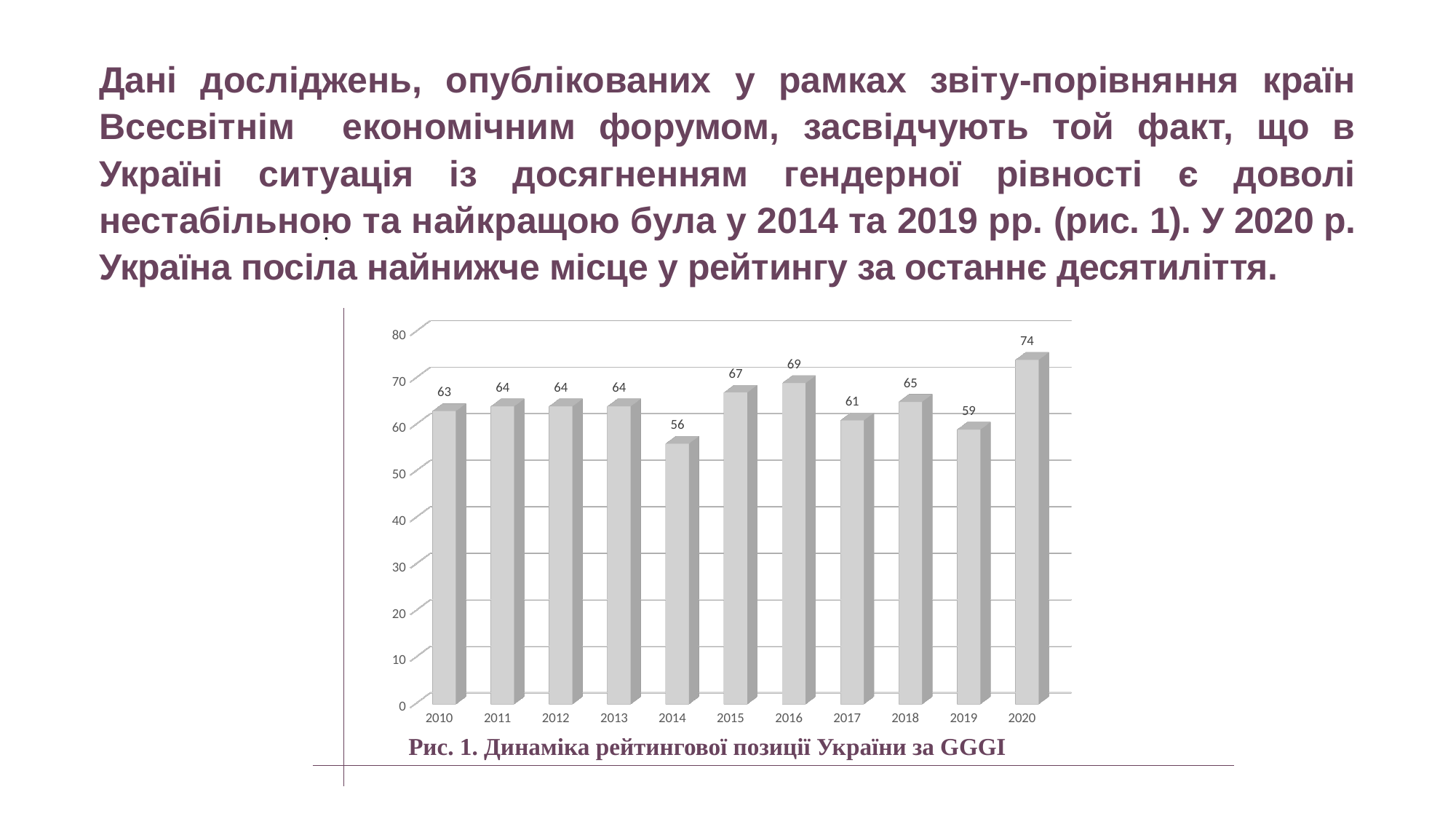
What is the value for 2014? 56 Which year has the highest value? 2020 What is the difference between the values for 2020 and 2014? 18 Which year has the lowest value? 2014 What is the caption of the chart? Рис. 1. Динаміка рейтингової позиції України за GGGI Is the value for 2019 greater or less than 60? less What is the value for 2016? 69 How many years are shown on the x axis? 11 Does the value rise or fall from 2019 to 2020? rise What is the value for 2020? 74 Which is larger, the value for 2017 or the value for 2018? 2018 What kind of chart is shown on the slide? bar chart